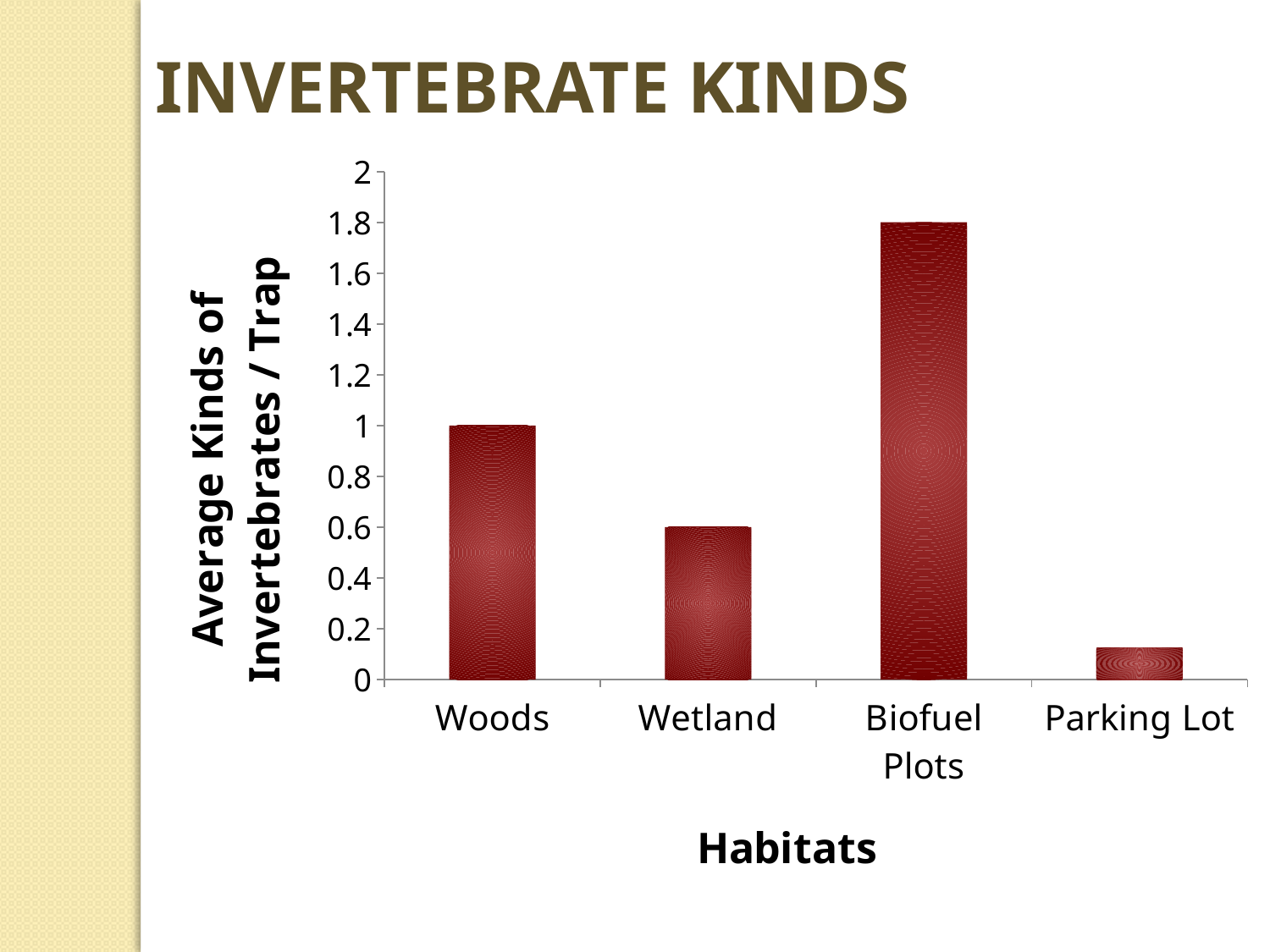
What is the difference between the values for Biofuel Plots and Woods? 0.8 Which habitat has the lowest average kinds of invertebrates per trap? Parking Lot What is the average kinds of invertebrates per trap for Woods? 1 What is the average kinds of invertebrates per trap for Biofuel Plots? 1.8 What kind of chart is shown on the slide? bar chart What is the label on the x axis of the chart? Habitats Is the value for Parking Lot greater or less than 0.2? less What is the title of the chart? INVERTEBRATE KINDS Which has a higher value, Woods or Wetland? Woods Which habitat has the highest average kinds of invertebrates per trap? Biofuel Plots What is the average kinds of invertebrates per trap for Wetland? 0.6 How many habitats are shown on the x axis of the chart? 4